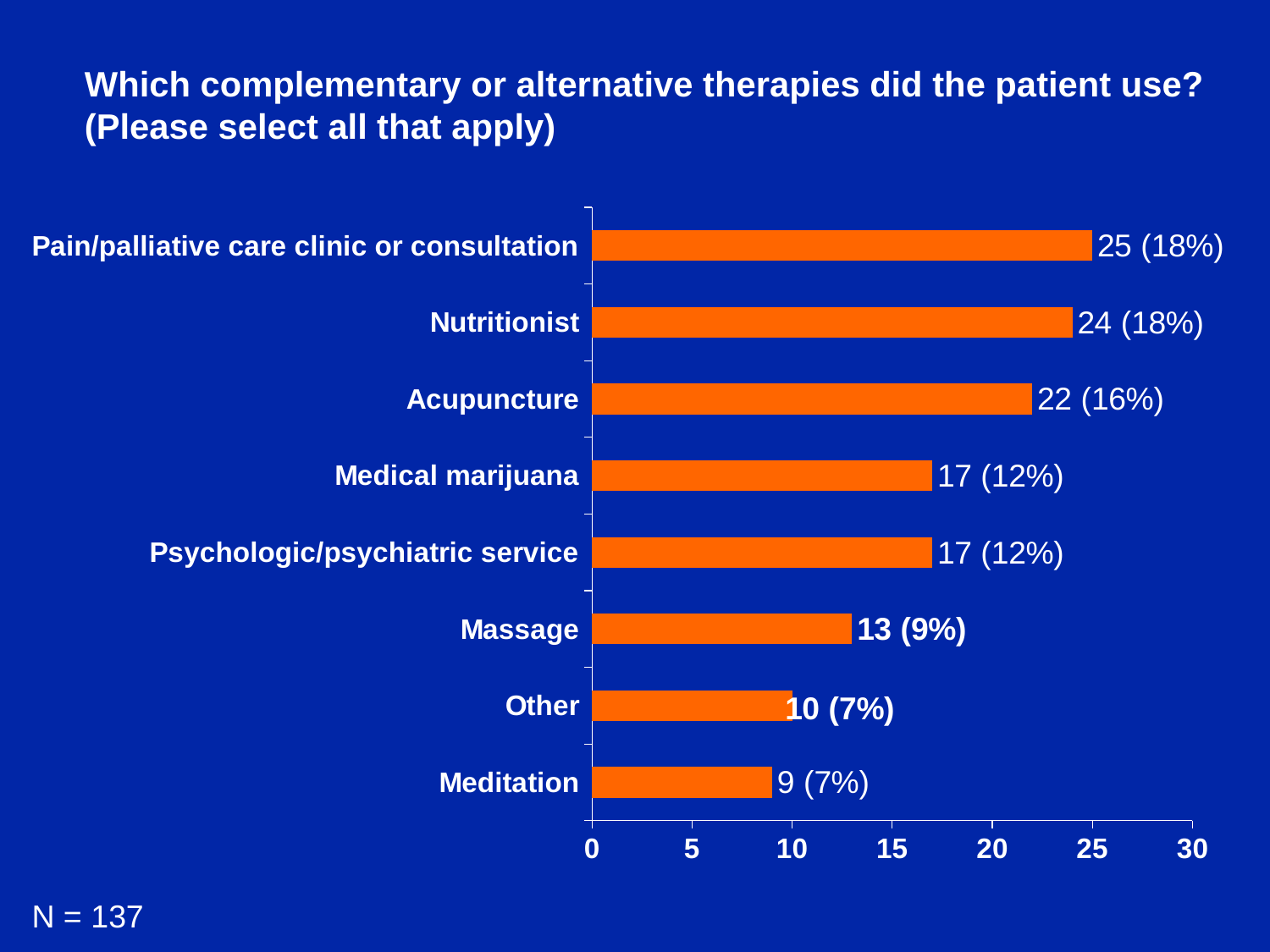
Which is larger, the value for Acupuncture or the value for Massage? Acupuncture What is the difference between the counts for Nutritionist and Medical marijuana? 7 What is the value for Acupuncture? 22 (16%) What is the value for Meditation? 9 (7%) What is the sample size (N) stated on the slide? 137 What colour are the bars in the chart? orange Which category has the highest value? Pain/palliative care clinic or consultation How many categories are shown in the chart? 8 Is the value for Other greater or less than 15? less What is the value for Massage? 13 (9%) What kind of chart is shown on the slide? bar chart Which category has the lowest value? Meditation